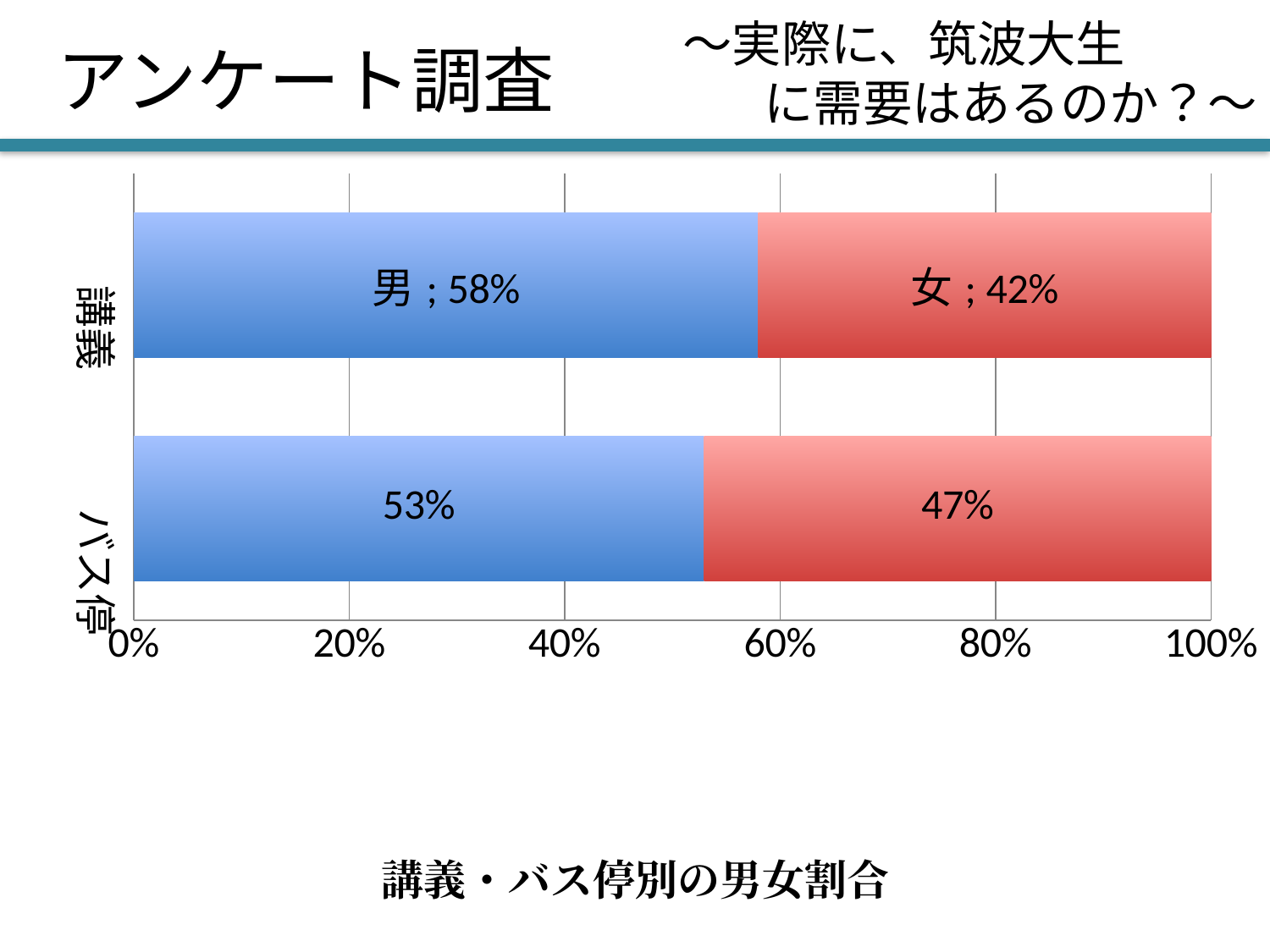
What percentage of respondents at バス停 are 男? 53% What kind of chart is shown on the slide? Stacked bar chart How many categories (locations) are shown on the chart? 2 What percentage of respondents at バス停 are 女? 47% What is the total of the 男 and 女 segments for the 講義 bar? 100% Which location has the higher share of 女 respondents, 講義 or バス停? バス停 Which location has the higher share of 男 respondents, 講義 or バス停? 講義 What percentage of respondents at 講義 are 女? 42% What is the caption below the chart? 講義・バス停別の男女割合 What percentage of respondents at 講義 are 男? 58% What is the difference between the 男 and 女 shares at バス停? 6% What is the difference between the 男 share at 講義 and the 男 share at バス停? 5%